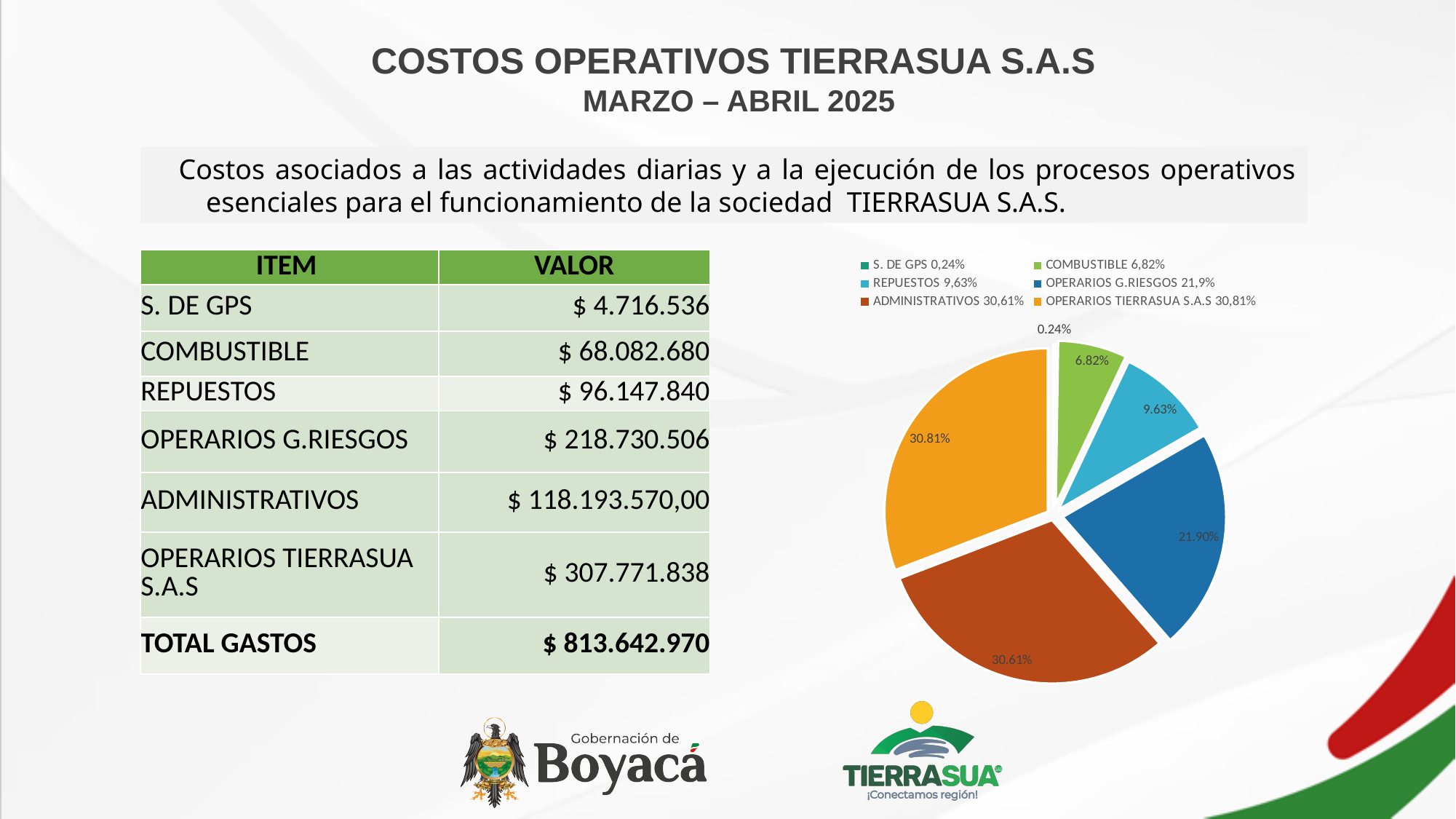
What is the difference in percentage points between the ADMINISTRATIVOS slice and the OPERARIOS G.RIESGOS slice? 8.71% Which category has the largest slice in the pie chart? OPERARIOS TIERRASUA S.A.S What percentage does the pie chart show for COMBUSTIBLE? 6.82% Which slice is larger in the pie chart, OPERARIOS G.RIESGOS or REPUESTOS? OPERARIOS G.RIESGOS What percentage does the pie chart show for REPUESTOS? 9.63% What is the difference in percentage points between the OPERARIOS G.RIESGOS slice and the REPUESTOS slice? 12.27% Which category has the smallest slice in the pie chart? S. DE GPS What kind of chart is shown on the slide? pie chart What colour is the OPERARIOS TIERRASUA S.A.S slice in the pie chart? orange What percentage does the pie chart show for OPERARIOS G.RIESGOS? 21.90% How many slices does the pie chart have? 6 What share of the pie does ADMINISTRATIVOS represent? 30.61%